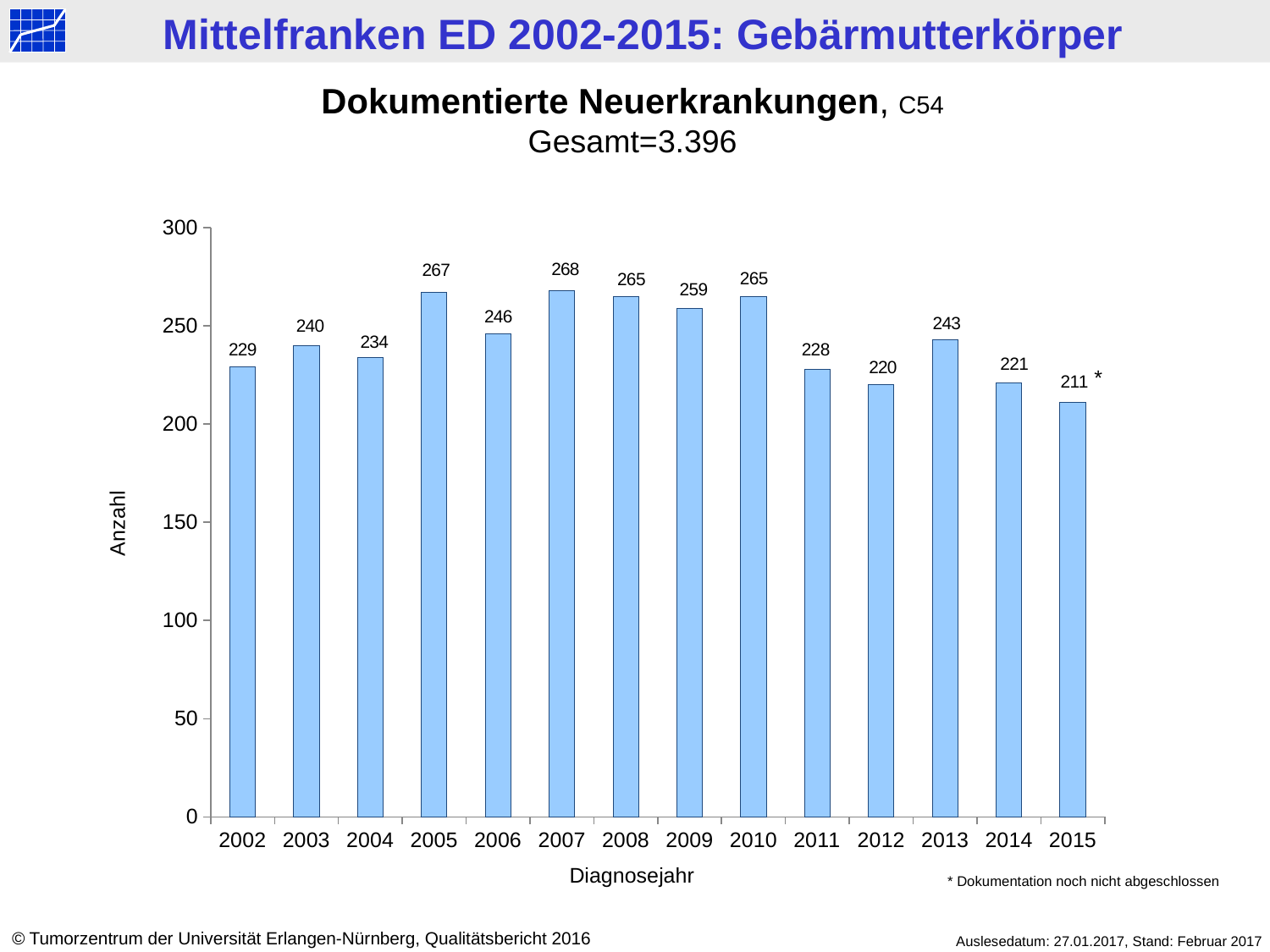
What is the difference between the values for 2007 and 2015? 57 Which year has the highest value? 2007 What is the value for 2007? 268 What is the label of the y axis? Anzahl Do the values rise or fall from 2010 to 2012? fall What kind of chart is this? bar chart Which is larger, the value for 2005 or the value for 2006? 2005 What is the value for 2002? 229 How many years are shown on the x axis? 14 Which year has the lowest value? 2015 Is the value for 2012 greater or less than 250? less What is the value for 2015? 211